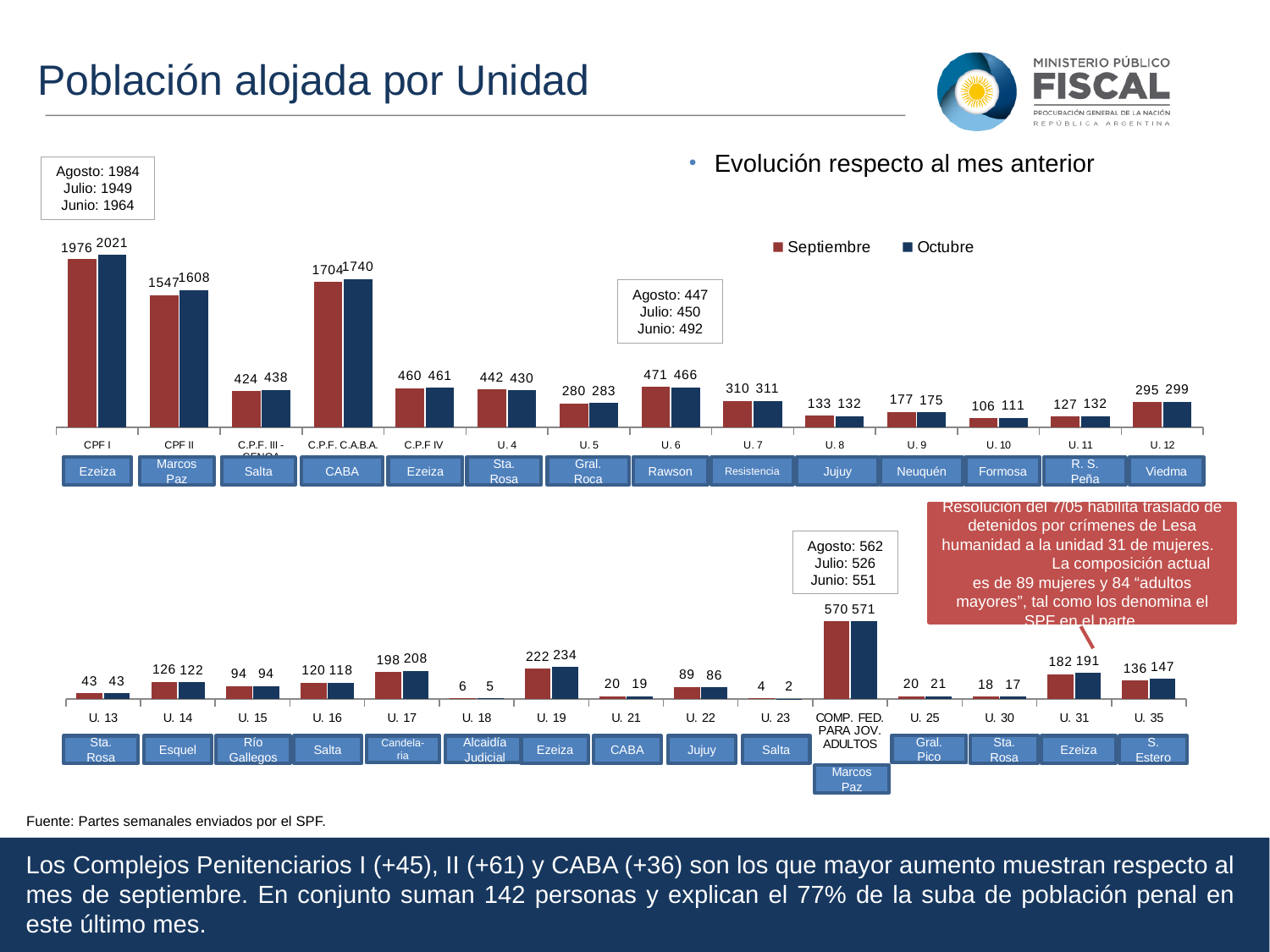
How many series does the legend list? 2 In the top chart, what is the Octubre value for CPF I? 2021 In the bottom chart, which category has the highest Septiembre value? COMP. FED. PARA JOV. ADULTOS In the bottom chart, which category has the lowest Octubre value? U. 23 In the top chart, which category has the highest Octubre value? CPF I What type of chart is used on this slide? Bar chart In the top chart, what is the Septiembre value for C.P.F. C.A.B.A.? 1704 In the bottom chart, what is the Octubre value for U. 19? 234 In the bottom chart, what is the difference between the Octubre and Septiembre values for U. 35? 11 In the top chart, which category has the lowest Septiembre value? U. 10 In the top chart, which is larger for U. 4: the Septiembre value or the Octubre value? Septiembre In the top chart, what is the difference between the Octubre and Septiembre values for CPF II? 61